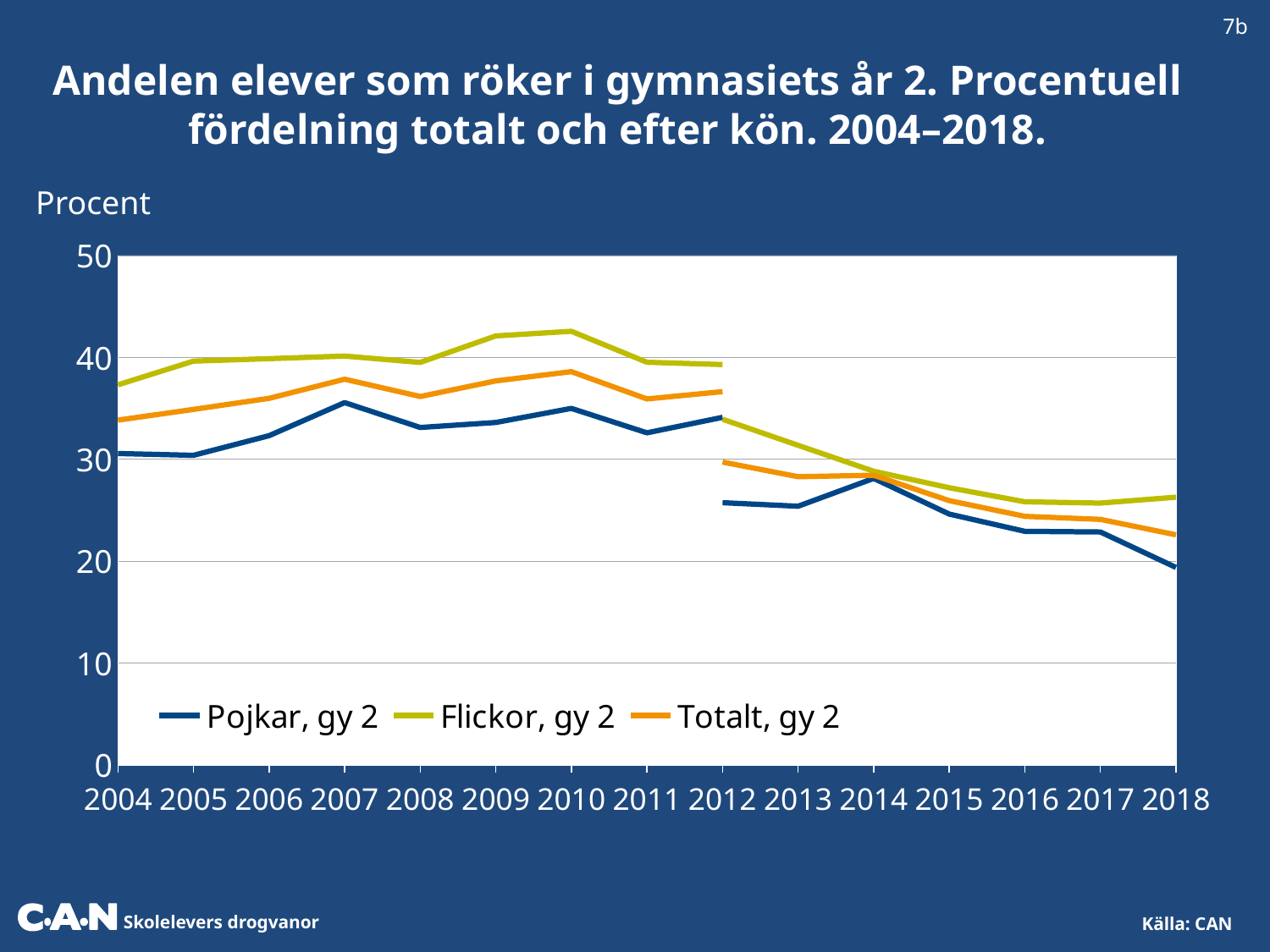
Is the value for Pojkar, gy 2 in 2018 greater or less than 20? less Is the value for Totalt, gy 2 in 2007 greater or less than 40? less In 2010, which is higher: Flickor, gy 2 or Pojkar, gy 2? Flickor, gy 2 How many years are shown on the x axis? 15 What is the label on the y axis? Procent How many series does the legend list? 3 Which series is drawn in orange? Totalt, gy 2 Does the value for Pojkar, gy 2 rise or fall from 2014 to 2018? fall Is the value for Flickor, gy 2 in 2016 greater or less than 30? less What kind of chart is shown on the slide? line chart In which year is the value for Pojkar, gy 2 lowest? 2018